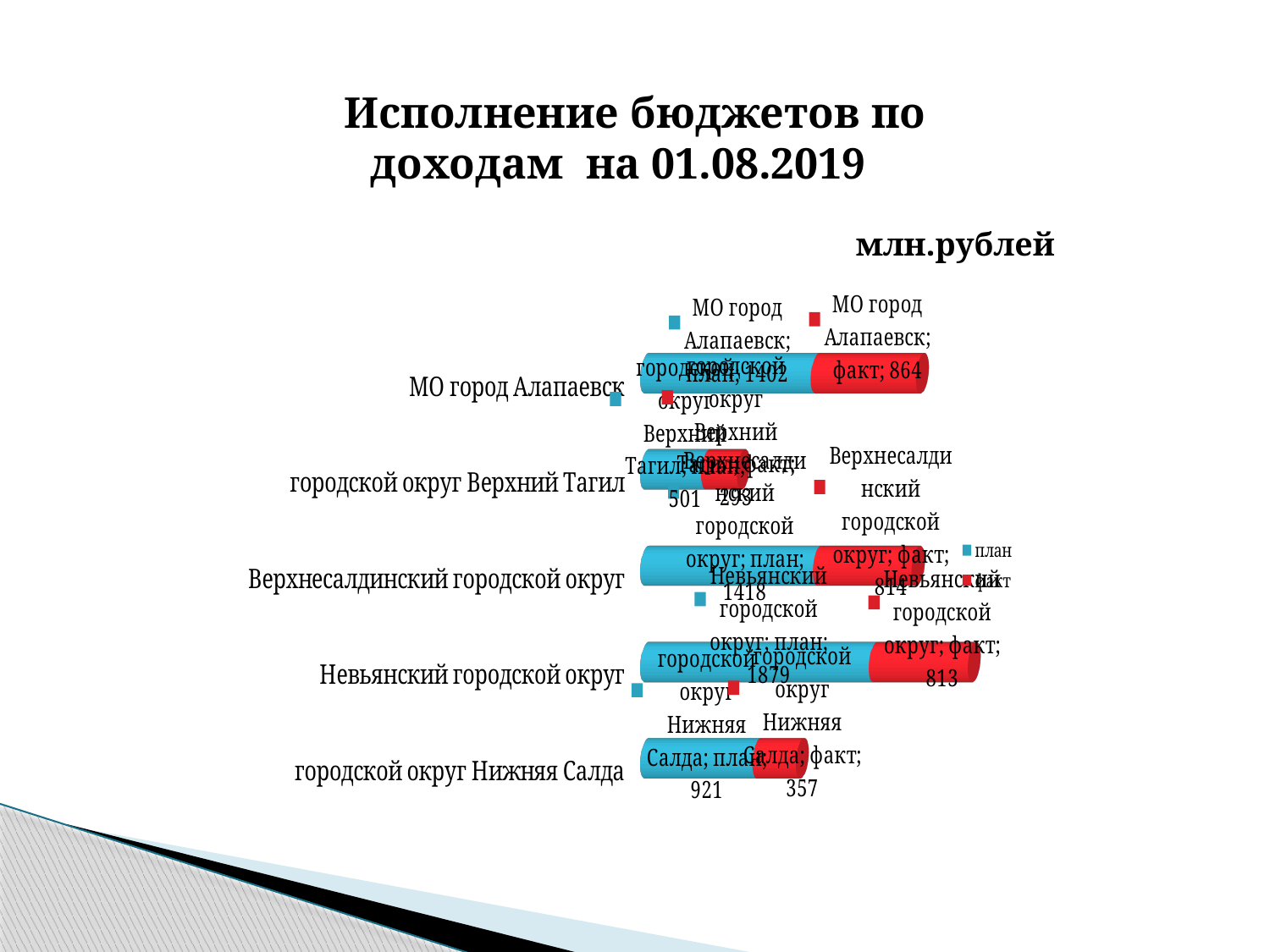
How many series does the legend list? 2 What is the факт value for МО город Алапаевск? 864 Which municipality has the lowest план value? городской округ Верхний Тагил What kind of chart is shown on the slide? bar chart What is the difference between план and факт for Невьянский городской округ? 1066 What is the план value for Верхнесалдинский городской округ? 1418 What is the факт value for городской округ Нижняя Салда? 357 What is the total of план and факт for городской округ Нижняя Салда? 1278 What is the план value for Невьянский городской округ? 1879 Which is larger: the план value for Верхнесалдинский городской округ or for городской округ Нижняя Салда? Верхнесалдинский городской округ How many municipalities (categories) are shown in the chart? 5 Which municipality has the highest план value? Невьянский городской округ